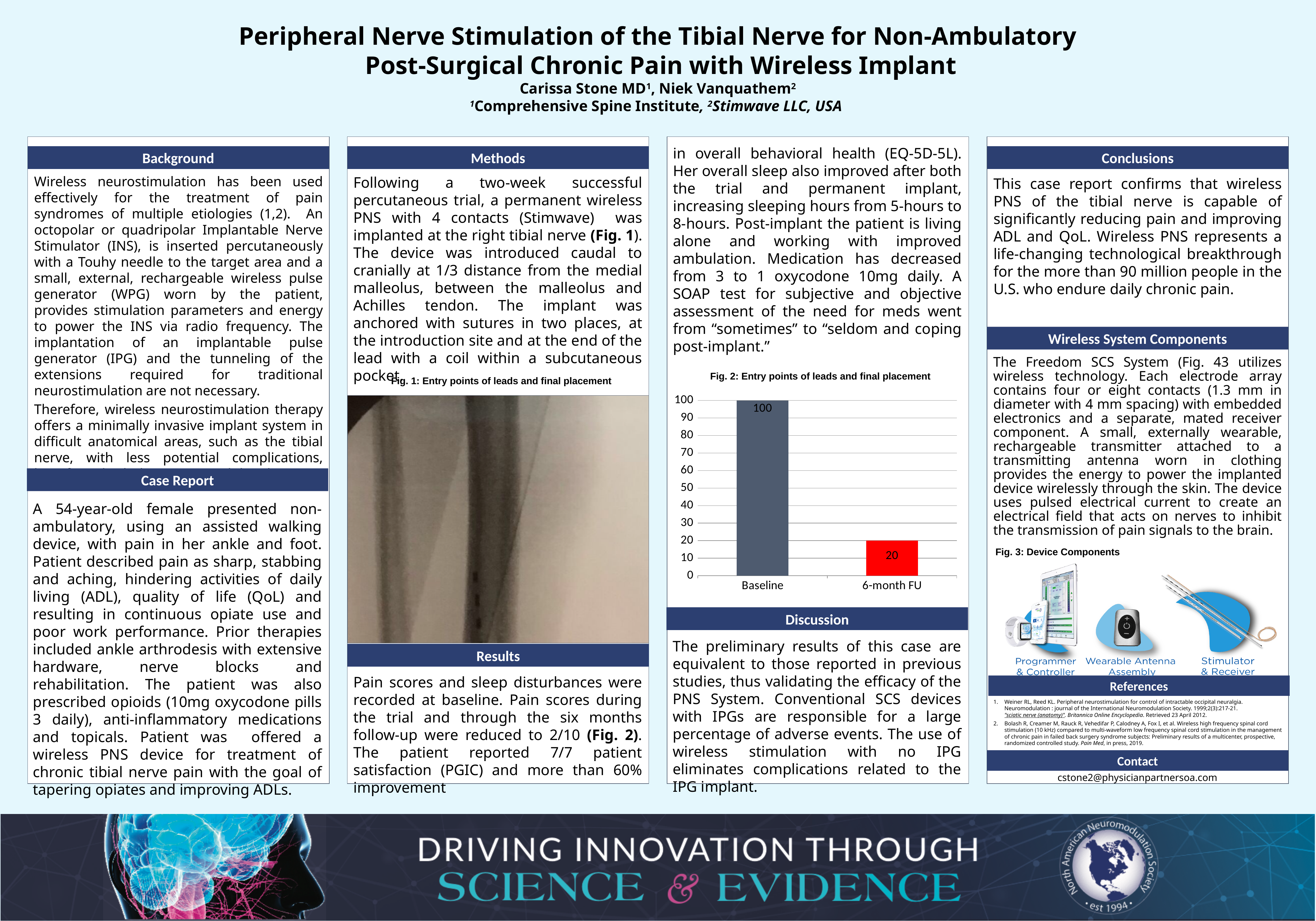
What colour is the 6-month FU bar in the Fig. 2 bar chart? red How many categories are shown on the x axis of the Fig. 2 bar chart? 2 What is the difference between the Baseline and 6-month FU values in the Fig. 2 bar chart? 80 Which category has the lowest value in the Fig. 2 bar chart? 6-month FU What is the value for Baseline in the Fig. 2 bar chart? 100 Do the values in the Fig. 2 bar chart rise or fall from Baseline to 6-month FU? fall What kind of chart is Fig. 2? bar chart What is the title of the bar chart labelled Fig. 2? Fig. 2: Entry points of leads and final placement What is the value for 6-month FU in the Fig. 2 bar chart? 20 Is the value for 6-month FU in the Fig. 2 bar chart greater or less than 50? less Which category has the highest value in the Fig. 2 bar chart? Baseline In the Fig. 2 bar chart, is the value for Baseline or 6-month FU larger? Baseline